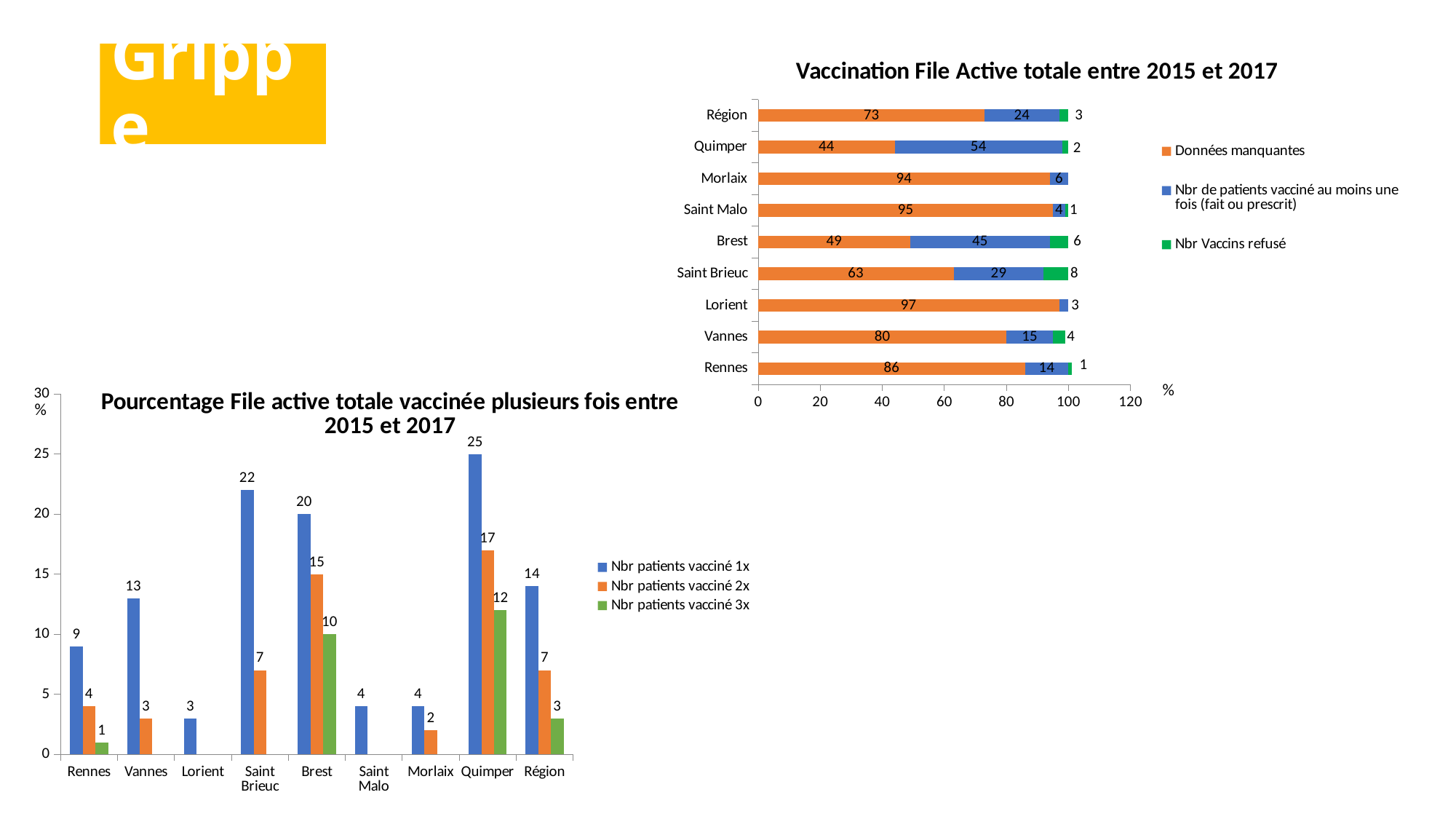
In the chart 'Vaccination File Active totale entre 2015 et 2017', which category has the highest value for 'Nbr Vaccins refusé'? Saint Brieuc In the chart 'Vaccination File Active totale entre 2015 et 2017', what is the total of the stacked bar for Brest? 100 In the chart 'Pourcentage File active totale vaccinée plusieurs fois entre 2015 et 2017', how many categories are shown on the x axis? 9 In the chart 'Vaccination File Active totale entre 2015 et 2017', what is the value of 'Données manquantes' for Lorient? 97 In the chart 'Pourcentage File active totale vaccinée plusieurs fois entre 2015 et 2017', what is the difference between 'Nbr patients vacciné 1x' and 'Nbr patients vacciné 2x' for Saint Brieuc? 15 What kind of chart is 'Pourcentage File active totale vaccinée plusieurs fois entre 2015 et 2017'? Bar chart In the chart 'Vaccination File Active totale entre 2015 et 2017', what is the difference between 'Données manquantes' for Morlaix and for Brest? 45 In the chart 'Vaccination File Active totale entre 2015 et 2017', how many series does the legend list? 3 In the chart 'Pourcentage File active totale vaccinée plusieurs fois entre 2015 et 2017', which category has the highest value for 'Nbr patients vacciné 1x'? Quimper In the chart 'Pourcentage File active totale vaccinée plusieurs fois entre 2015 et 2017', which is larger: 'Nbr patients vacciné 3x' for Quimper or for Brest? Quimper In the chart 'Vaccination File Active totale entre 2015 et 2017', what is the value of 'Nbr de patients vacciné au moins une fois (fait ou prescrit)' for Quimper? 54 In the chart 'Pourcentage File active totale vaccinée plusieurs fois entre 2015 et 2017', what is the value of 'Nbr patients vacciné 2x' for Brest? 15